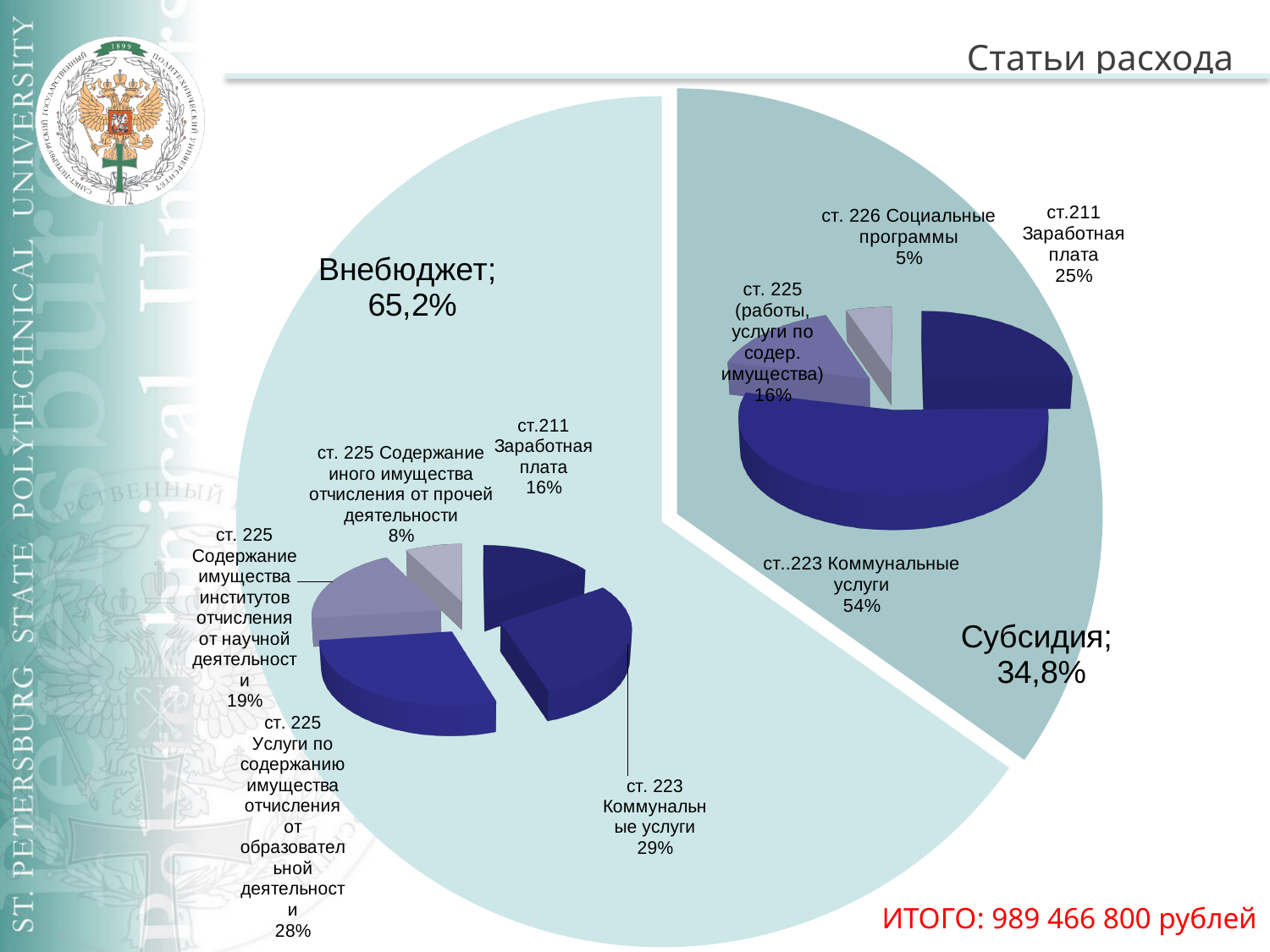
In the lower-left pie chart (Внебюджет), which category has the smallest share? ст. 225 Содержание иного имущества отчисления от прочей деятельности In the large background pie chart, what share is labelled for Субсидия? 34,8% In the large background pie chart, what share is labelled for Внебюджет? 65,2% In the lower-left pie chart (Внебюджет), what percentage is shown for ст. 223 Коммунальные услуги? 29% In the upper-right pie chart (Субсидия), what percentage is shown for ст..223 Коммунальные услуги? 54% What type of charts are shown on the slide? Pie charts In the upper-right pie chart (Субсидия), what is the difference in percentage points between ст.211 Заработная плата and ст. 226 Социальные программы? 20 In the upper-right pie chart (Субсидия), which category has the largest share? ст..223 Коммунальные услуги In the upper-right pie chart (Субсидия), how many slices are there? 4 In the lower-left pie chart (Внебюджет), what percentage is shown for ст.211 Заработная плата? 16% In the lower-left pie chart (Внебюджет), how many slices are there? 5 What total amount (ИТОГО) is stated on the slide? 989 466 800 рублей